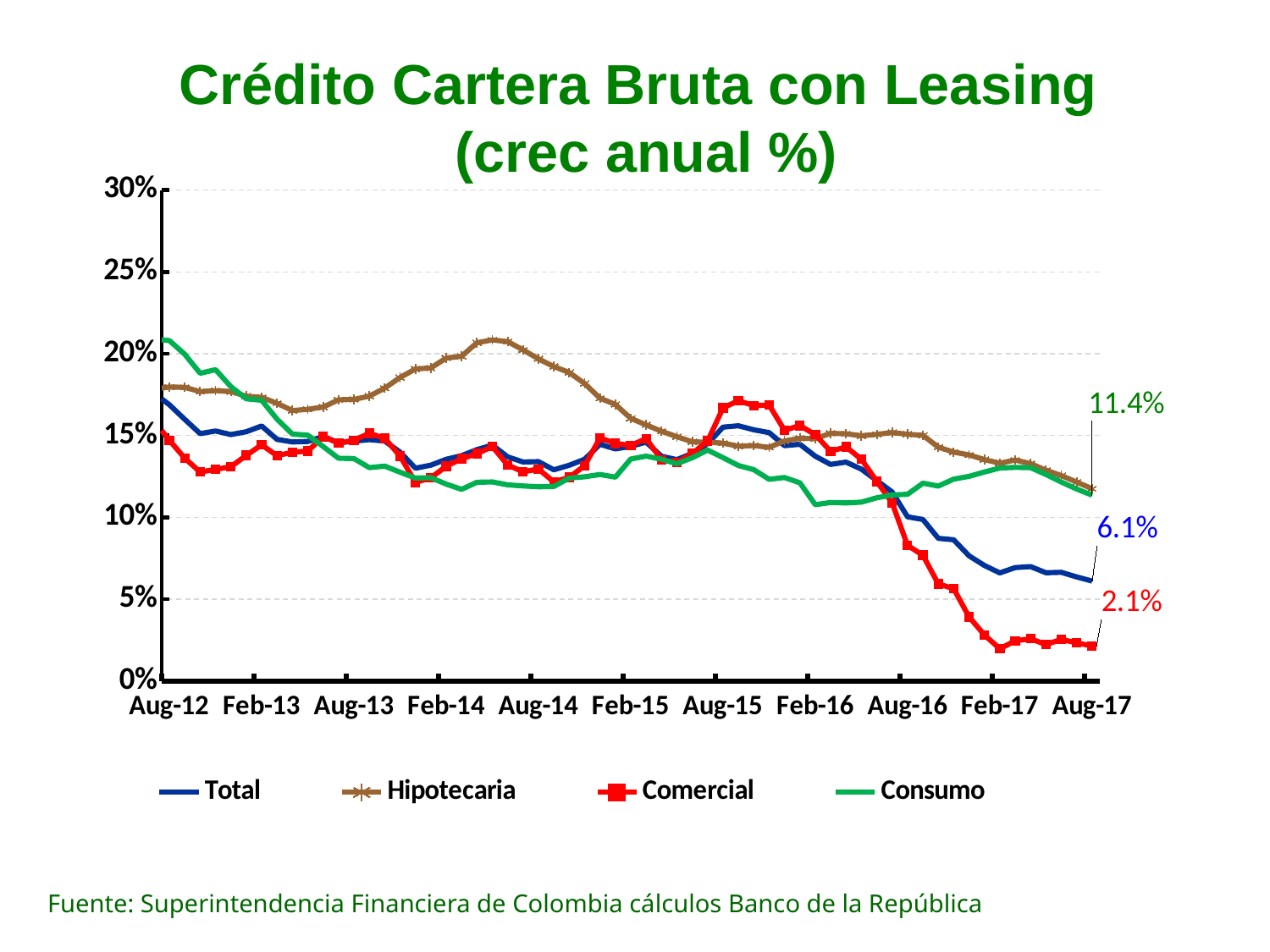
Is the value of Comercial at Feb-17 greater or less than 5%? less What kind of chart is shown on the slide? Line chart What is the value of the Comercial series at Aug-17? 2.1% What is the value of the Consumo series at Aug-17? 11.4% At Aug-17, what is the difference between Total and Comercial? 4.0% What is the value of the Total series at Aug-17? 6.1% Is the value of Hipotecaria at Feb-14 greater or less than 15%? greater Which series has the lowest value at Aug-17? Comercial Does the Comercial series rise or fall between Aug-15 and Aug-17? Fall How many series does the legend list? 4 At Aug-17, how much higher is Consumo than Total? 5.3% At Aug-17, which is larger, Consumo or Comercial? Consumo